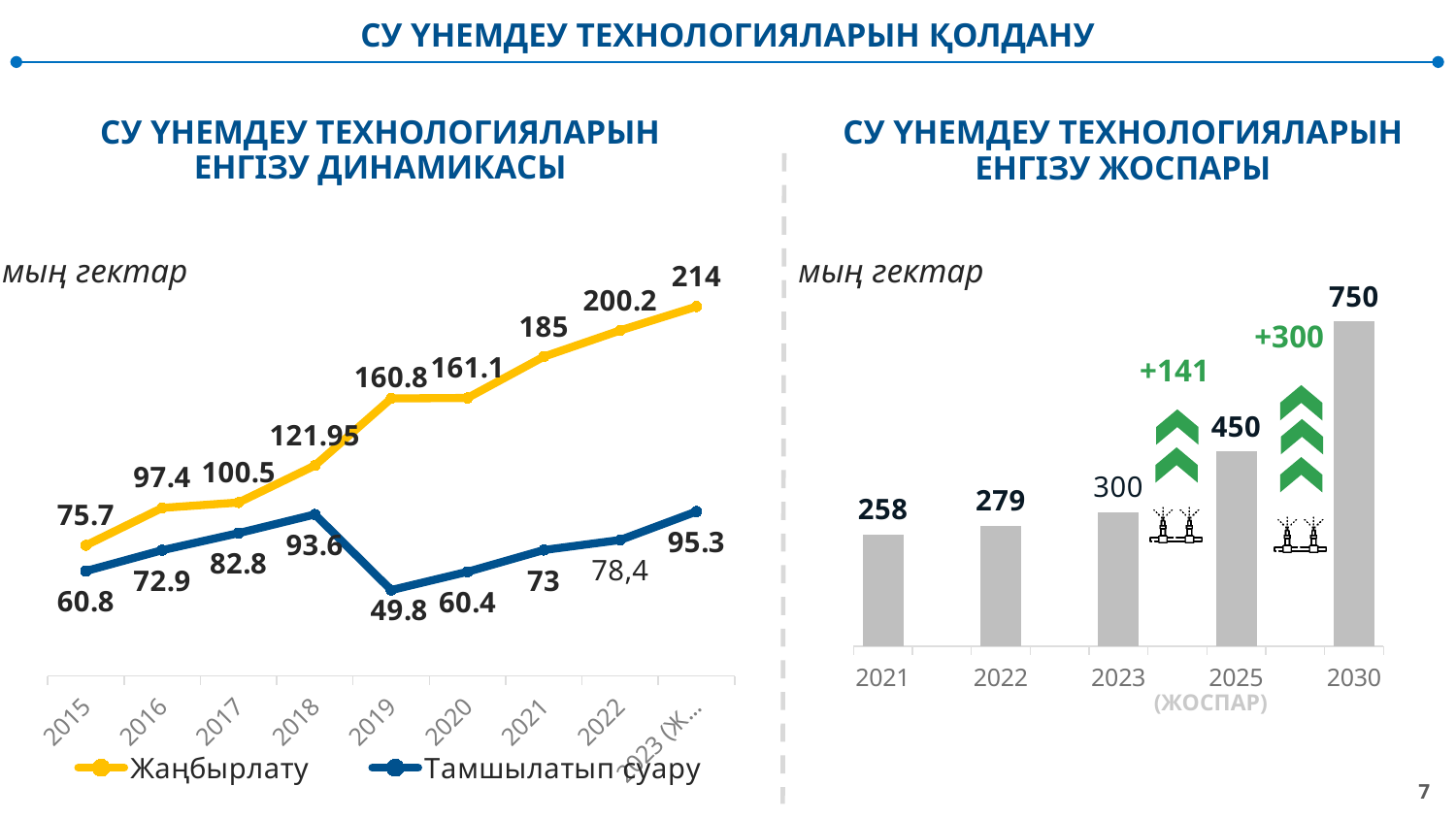
In the left chart (ЕНГІЗУ ДИНАМИКАСЫ), which series has the larger value in 2015, Жаңбырлату or Тамшылатып суару? Жаңбырлату What kind of chart is the left chart (ЕНГІЗУ ДИНАМИКАСЫ)? line chart In the left chart (ЕНГІЗУ ДИНАМИКАСЫ), what is the value for Жаңбырлату in 2018? 121.95 In the left chart (ЕНГІЗУ ДИНАМИКАСЫ), what is the difference between Жаңбырлату and Тамшылатып суару in 2022? 121.8 In the right chart (ЕНГІЗУ ЖОСПАРЫ), how many bars are shown? 5 In the left chart (ЕНГІЗУ ДИНАМИКАСЫ), what is the value for Тамшылатып суару in 2019? 49.8 In the left chart (ЕНГІЗУ ДИНАМИКАСЫ), in which year is the Тамшылатып суару value lowest? 2019 In the right chart (ЕНГІЗУ ЖОСПАРЫ), what is the value for 2025? 450 In the right chart (ЕНГІЗУ ЖОСПАРЫ), what is the difference between the 2030 and 2025 values? 300 In the left chart (ЕНГІЗУ ДИНАМИКАСЫ), how many series does the legend list? 2 In the left chart (ЕНГІЗУ ДИНАМИКАСЫ), what is the highest value shown for Жаңбырлату? 214 In the right chart (ЕНГІЗУ ЖОСПАРЫ), do the values rise or fall from 2021 to 2030? rise